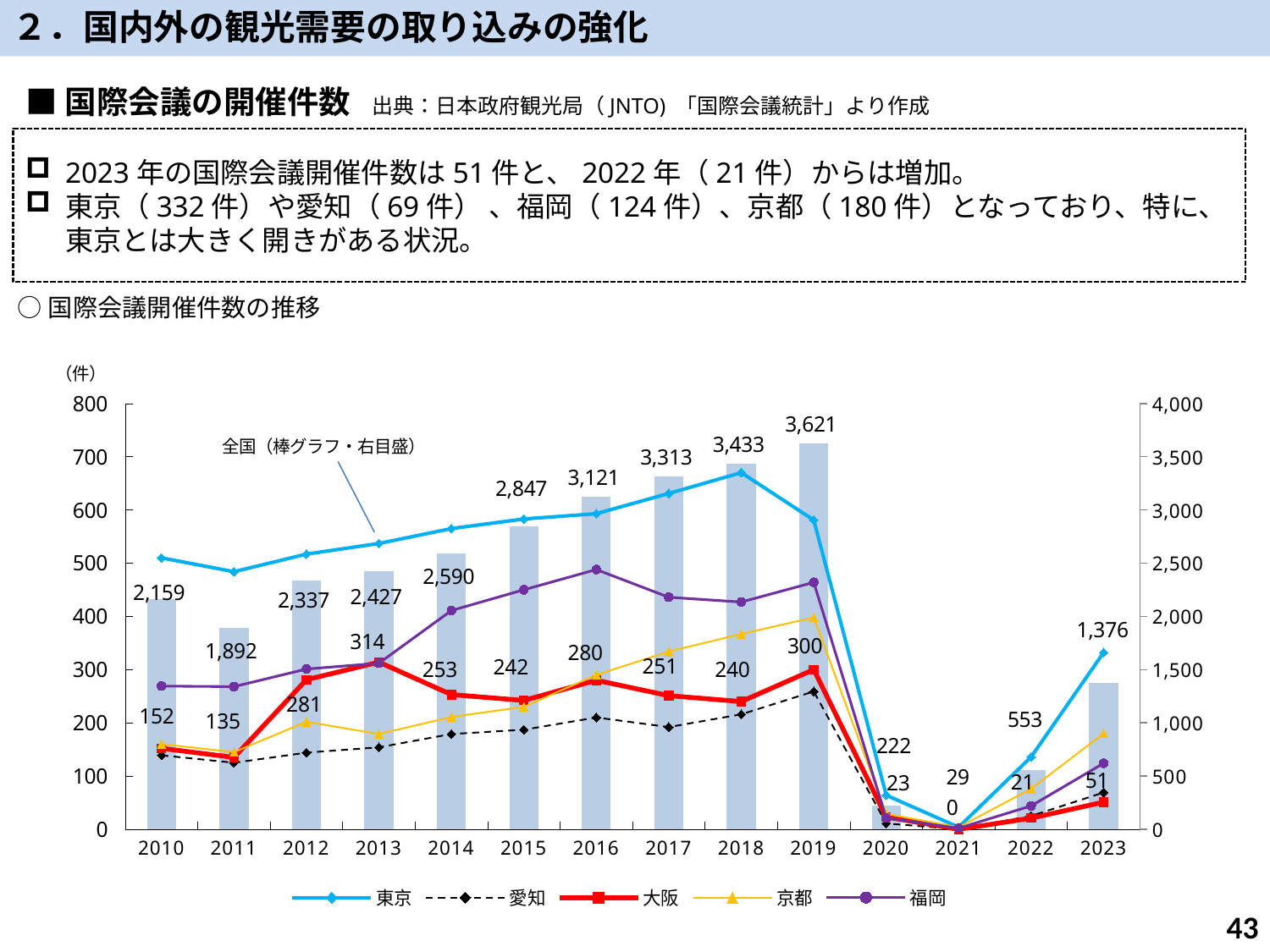
How many series does the legend list? 5 What is the value of the 大阪 line in 2013? 314 What kind of chart is this? Combination bar and line chart What is the value of the 全国 bar for 2019? 3,621 What is the difference between the 大阪 values for 2023 and 2022? 30 How many years are shown on the x axis? 14 Which year has the larger 全国 value, 2020 or 2022? 2022 Is the value for 東京 in 2018 greater or less than 600? greater In which year is the 全国 bar the highest? 2019 What is the value of the 大阪 line in 2021? 0 What is the difference between the 全国 values for 2019 and 2018? 188 In which year is the 全国 bar the lowest? 2021